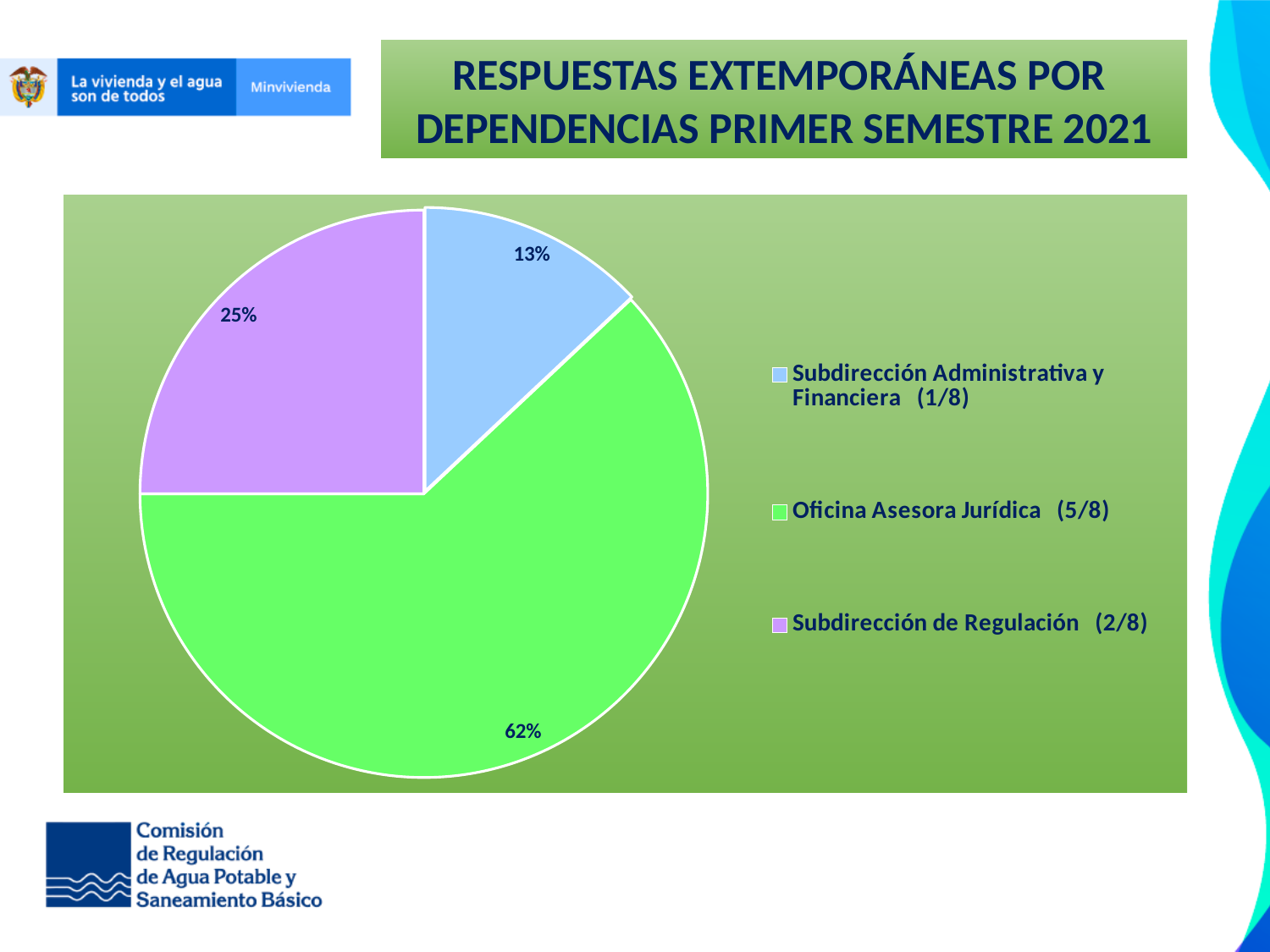
What share of the pie does Subdirección de Regulación (2/8) represent? 25% What share of the pie does Oficina Asesora Jurídica (5/8) represent? 62% How many entries does the legend list? 3 What kind of chart is shown on the slide? Pie chart What is the difference in percentage points between the Oficina Asesora Jurídica slice and the Subdirección de Regulación slice? 37 What is the title of the chart? RESPUESTAS EXTEMPORÁNEAS POR DEPENDENCIAS PRIMER SEMESTRE 2021 How many slices does the pie chart have? 3 What share of the pie does Subdirección Administrativa y Financiera (1/8) represent? 13% Which slice is larger: Subdirección de Regulación or Subdirección Administrativa y Financiera? Subdirección de Regulación Which dependency has the smallest slice of the pie? Subdirección Administrativa y Financiera (1/8) What colour is the slice for Oficina Asesora Jurídica (5/8)? Green Which dependency has the largest slice of the pie? Oficina Asesora Jurídica (5/8)